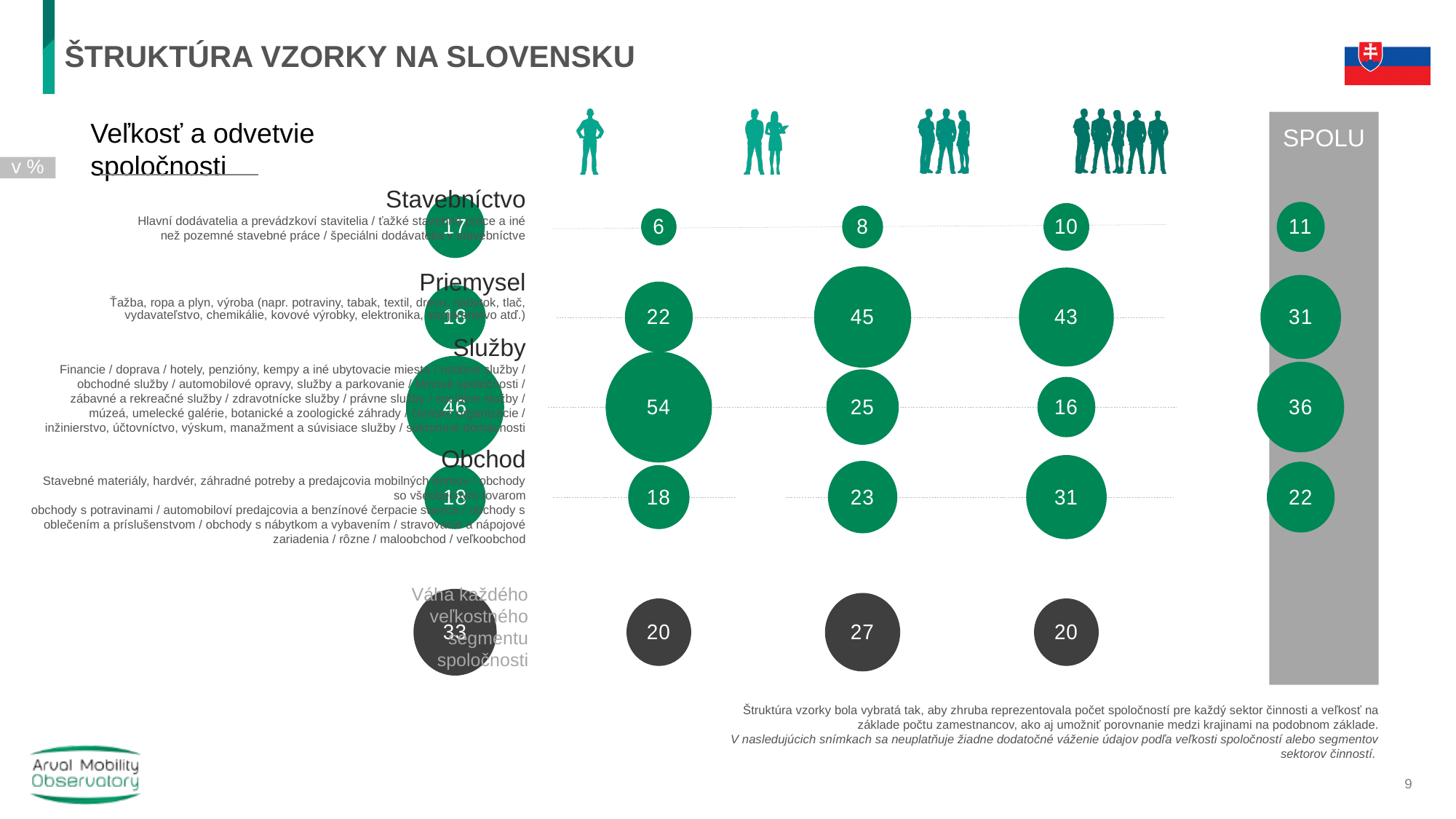
In the largest company-size column (the group of five figures), what is the value for Priemysel? 43 In the second company-size column (two figures), what is the value for Služby? 54 What is the weight (Váha) of the third company-size segment, shown in the dark grey bubble? 27 What is the difference between the SPOLU values for Služby and Stavebníctvo? 25 How many sectors (rows) are shown in the chart, excluding the weight row? 4 What is the SPOLU (total) value for Obchod? 22 Which is larger: the Obchod value in the third company-size column (three figures) or in the largest company-size column (five figures)? largest company-size column (31) Which sector has the lowest SPOLU value? Stavebníctvo What is the SPOLU (total) value for Priemysel? 31 What is the SPOLU (total) value for Stavebníctvo? 11 What is the SPOLU (total) value for Služby? 36 Which sector has the highest SPOLU value? Služby